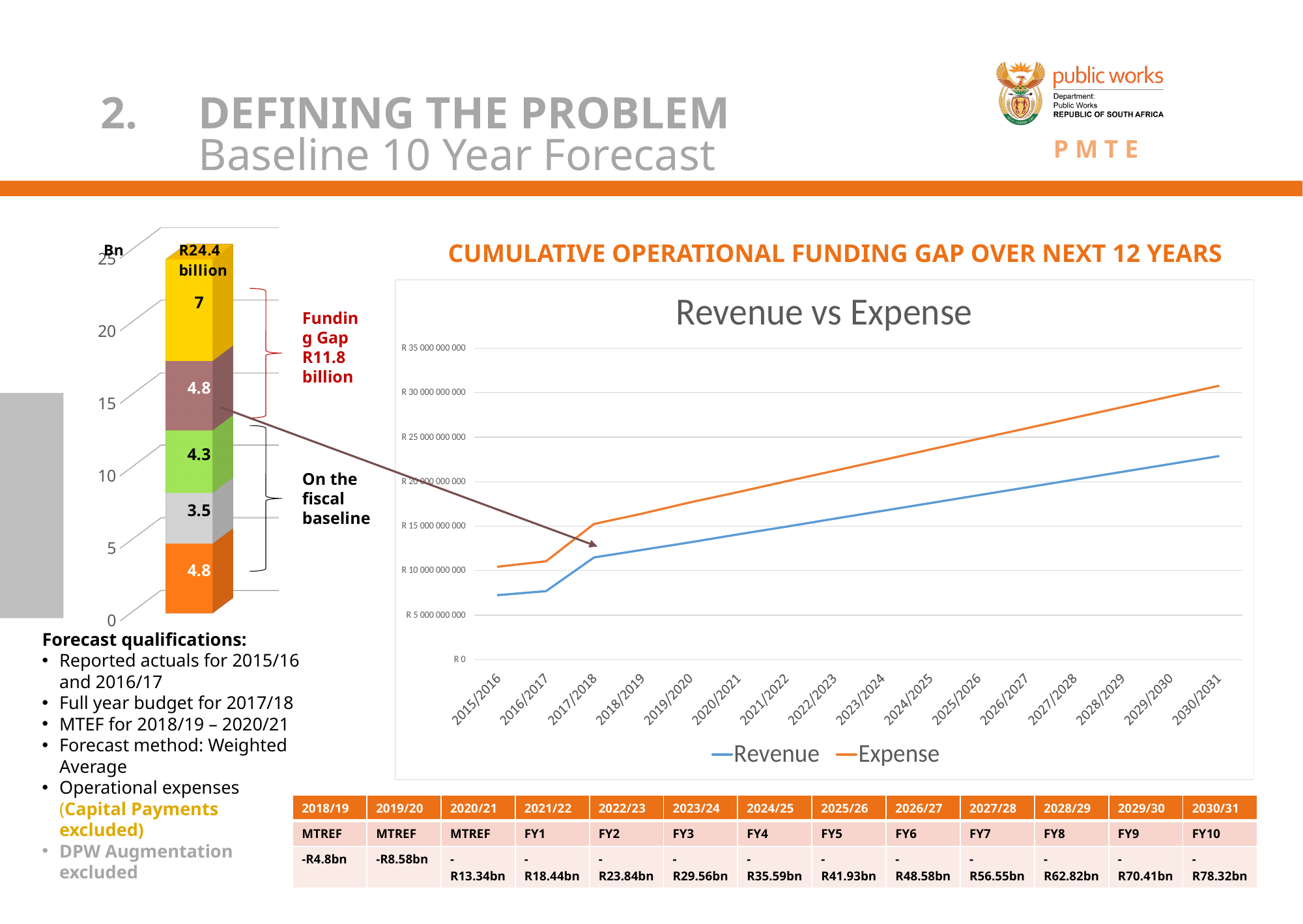
What type of chart is the 'Revenue vs Expense' chart? line chart In the 'Revenue vs Expense' chart, is the Expense value for 2024/2025 greater or less than R 20 000 000 000? greater In the stacked bar chart on the left, how many segments make up the bar? 5 What type of chart is the chart on the left of the slide with the R24.4 billion label? bar chart In the 'Revenue vs Expense' chart, which series is higher in 2030/2031, Revenue or Expense? Expense In the 'Revenue vs Expense' chart, is the Revenue value for 2015/2016 greater or less than R 10 000 000 000? less In the 'Revenue vs Expense' chart, what colour is the Expense line? orange How many series does the legend of the 'Revenue vs Expense' chart list? 2 How many fiscal years are shown on the x axis of the 'Revenue vs Expense' chart? 16 In the 'Revenue vs Expense' chart, do the Expense values rise or fall from 2015/2016 to 2030/2031? rise In the stacked bar chart on the left, what is the value of the largest segment? 7 In the 'Revenue vs Expense' chart, is the Revenue value for 2030/2031 greater or less than R 25 000 000 000? less